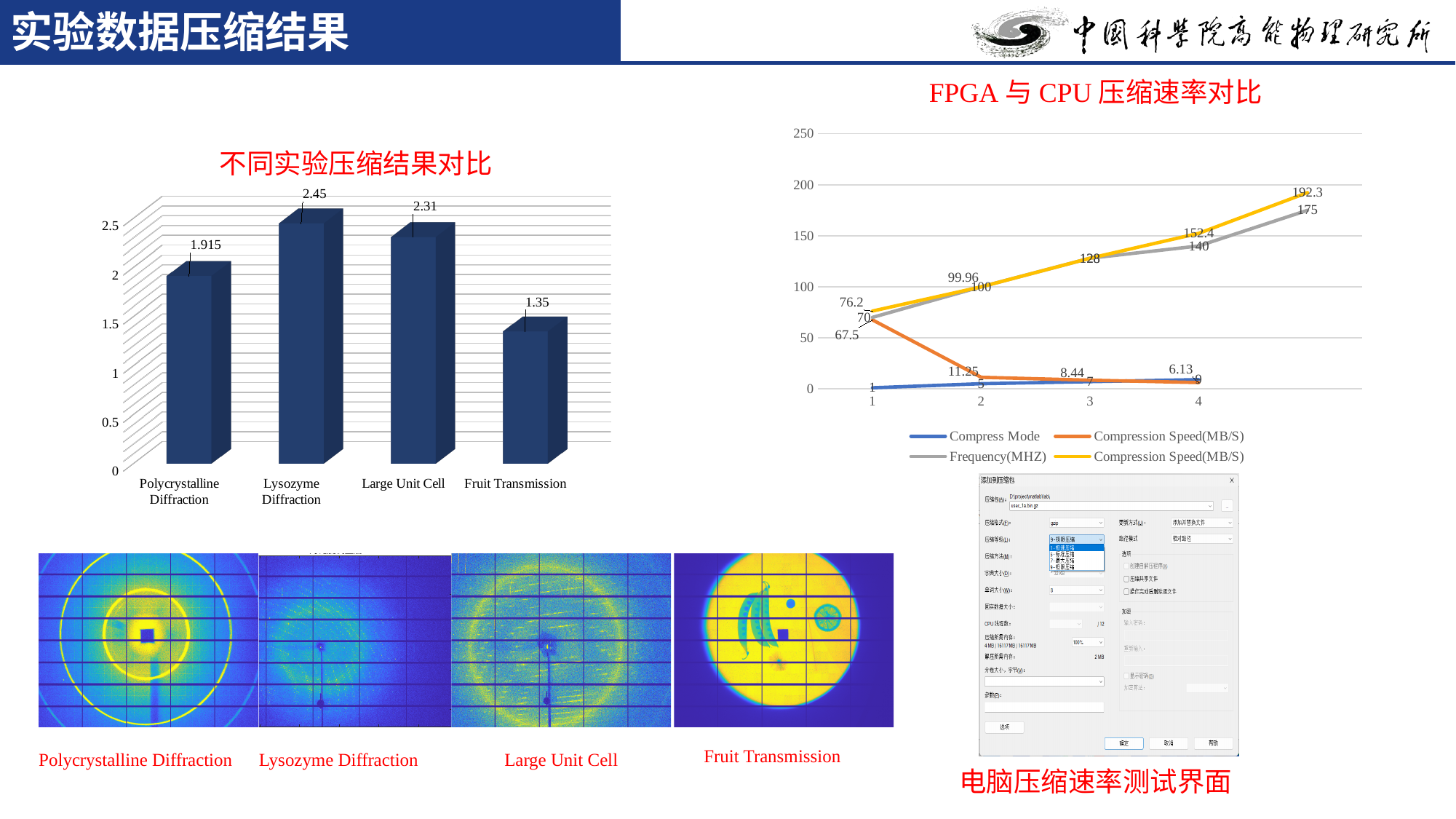
In the line chart titled FPGA 与 CPU 压缩速率对比, how many series does the legend list? 4 In the bar chart titled 不同实验压缩结果对比, what is the value for Lysozyme Diffraction? 2.45 In the bar chart titled 不同实验压缩结果对比, what is the value for Fruit Transmission? 1.35 In the bar chart titled 不同实验压缩结果对比, what is the difference between the values for Lysozyme Diffraction and Large Unit Cell? 0.14 In the bar chart titled 不同实验压缩结果对比, which category has the highest value? Lysozyme Diffraction In the line chart titled FPGA 与 CPU 压缩速率对比, does the orange Compression Speed(MB/S) series rise or fall from x = 1 to x = 4? Fall In the line chart titled FPGA 与 CPU 压缩速率对比, what is the value of the orange Compression Speed(MB/S) series at x = 1? 67.5 In the bar chart titled 不同实验压缩结果对比, how many categories are shown? 4 In the line chart titled FPGA 与 CPU 压缩速率对比, at x = 4, which is larger: the yellow Compression Speed(MB/S) series or the Frequency(MHZ) series? The yellow Compression Speed(MB/S) series In the bar chart titled 不同实验压缩结果对比, which category has the lowest value? Fruit Transmission In the line chart titled FPGA 与 CPU 压缩速率对比, what is the value of the Frequency(MHZ) series at x = 4? 140 What kind of chart is the chart titled 不同实验压缩结果对比? Bar chart